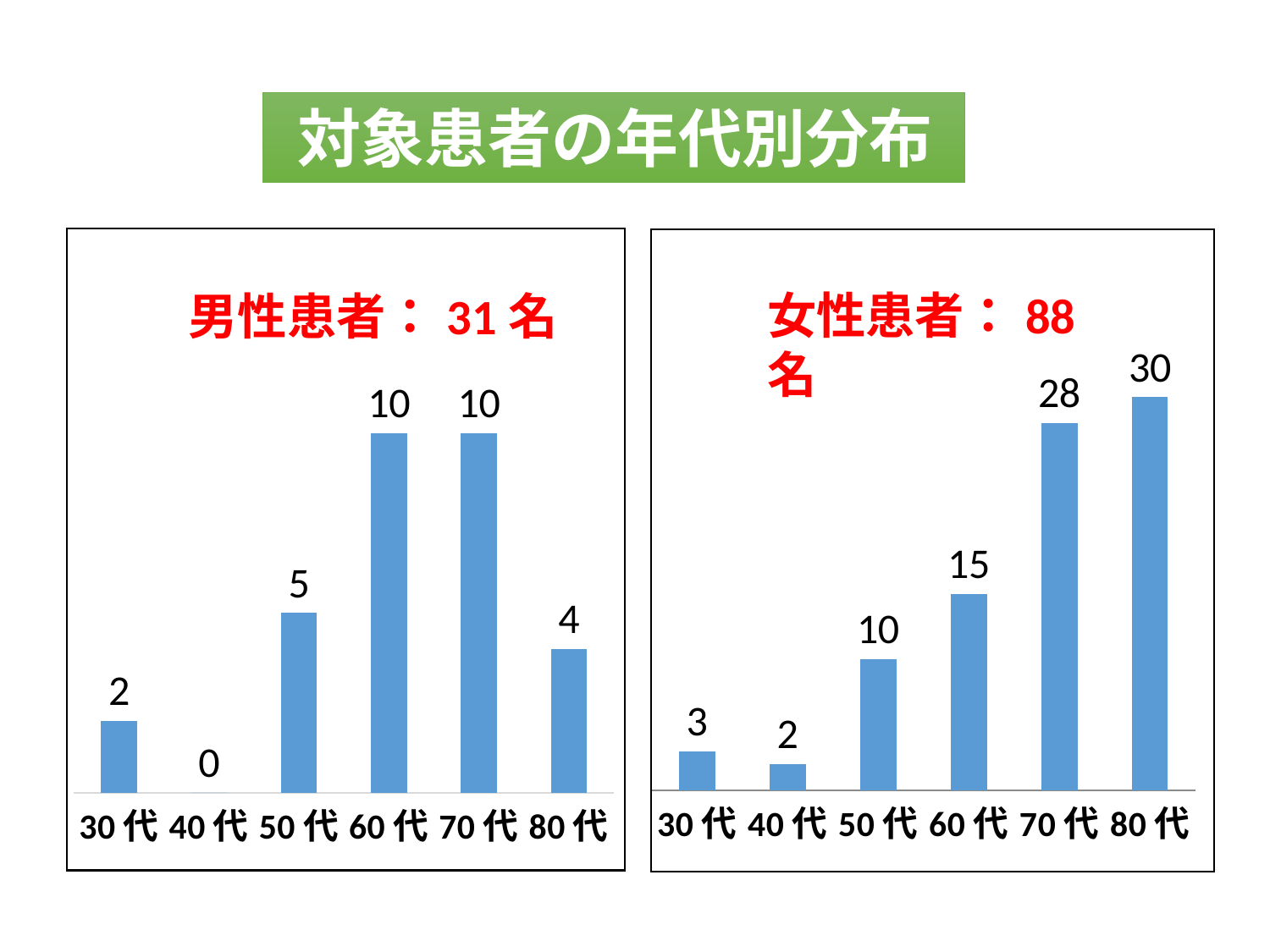
In the left chart (男性患者), what is the value for 30代? 2 In the right chart (女性患者), do the values generally rise or fall from 40代 to 80代? rise According to the text in the right chart, how many female patients (女性患者) are there? 88名 In the left chart (男性患者), what is the value for 60代? 10 What kind of chart is the right chart (女性患者)? bar chart In the left chart (男性患者), which age group has the lowest value? 40代 In the left chart (男性患者), which is larger, the value for 50代 or the value for 80代? 50代 In the right chart (女性患者), what is the value for 70代? 28 In the right chart (女性患者), what is the difference between the values for 80代 and 50代? 20 What is the title of the slide? 対象患者の年代別分布 In the right chart (女性患者), which age group has the highest value? 80代 How many age groups are shown on the x axis of the left chart (男性患者)? 6